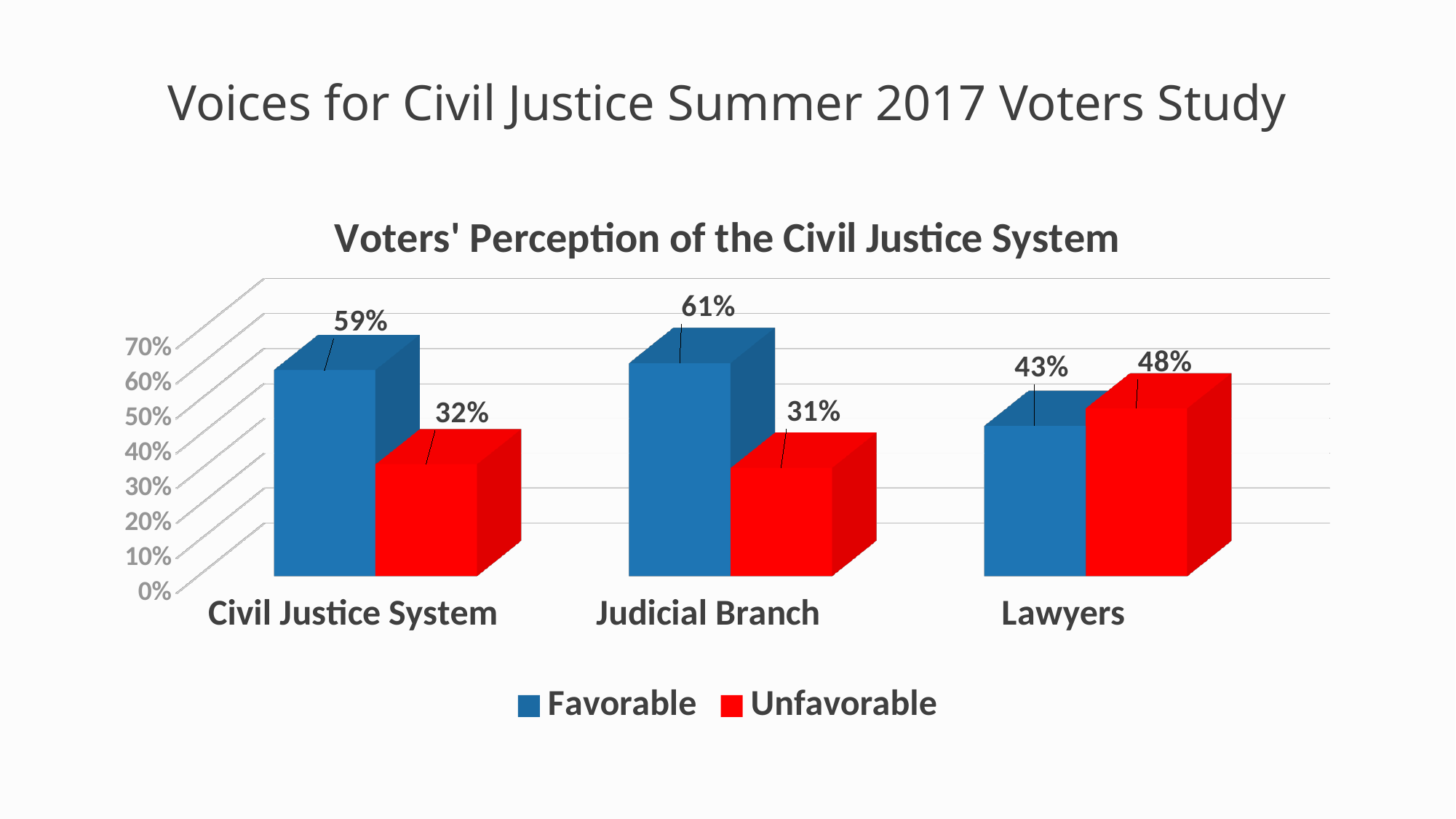
What is the difference between the Favorable and Unfavorable values for Civil Justice System? 27% For Lawyers, which is larger: the Favorable or the Unfavorable value? Unfavorable How many series does the legend list? 2 What kind of chart is shown on the slide? Bar chart What is the Favorable value for Civil Justice System? 59% Which category has the lowest Favorable value? Lawyers Which category has the highest Favorable value? Judicial Branch Which category has the highest Unfavorable value? Lawyers What is the title of the chart? Voters' Perception of the Civil Justice System What is the Unfavorable value for Judicial Branch? 31% How many categories are shown on the x axis? 3 What is the Unfavorable value for Lawyers? 48%